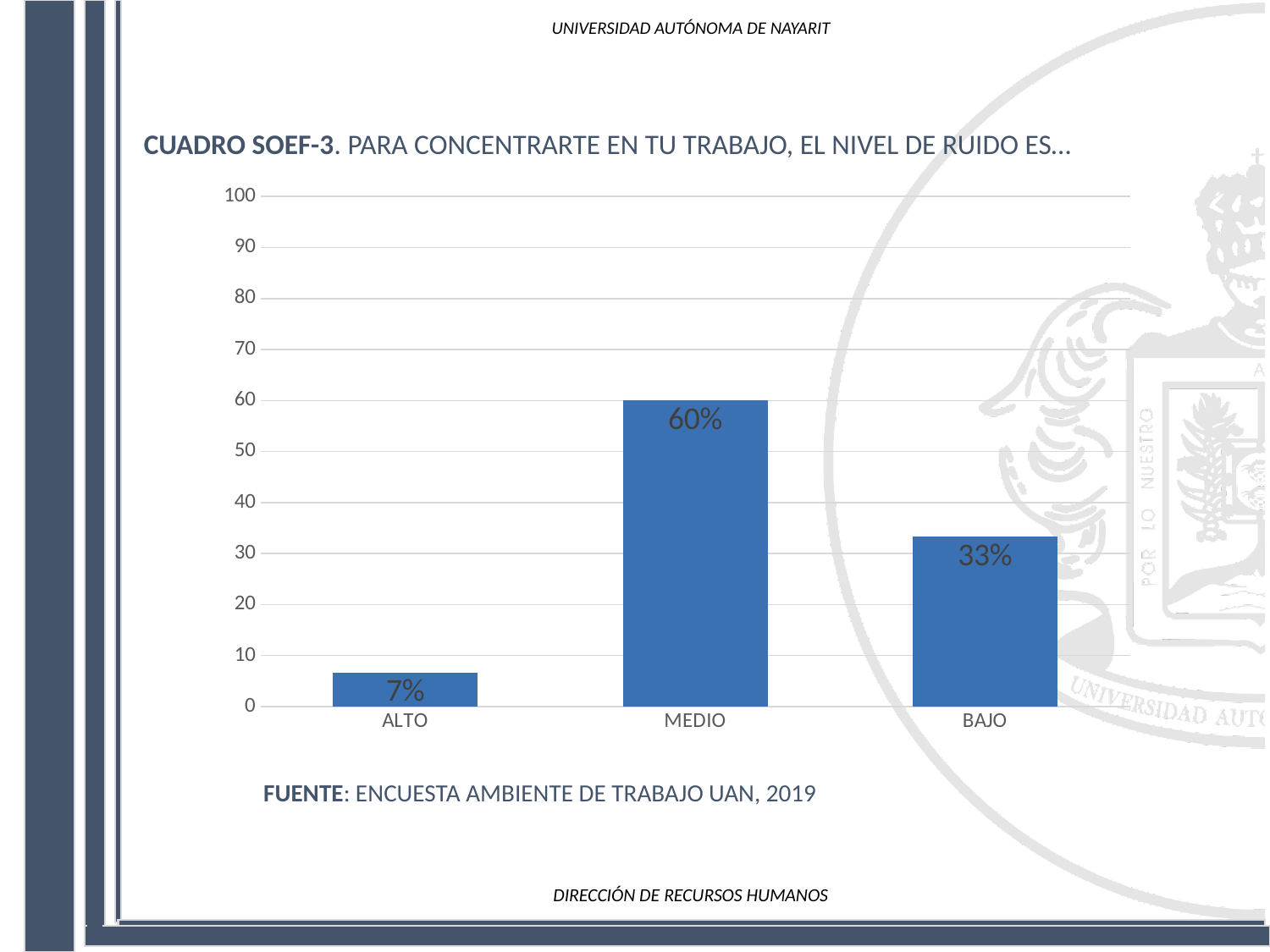
How many categories are shown on the x axis? 3 What kind of chart is shown on the slide? bar chart Which category has the lowest value? ALTO What is the value for BAJO? 33% What is the difference between the values for BAJO and ALTO? 26% What is the difference between the values for MEDIO and BAJO? 27% Which is larger, the value for BAJO or the value for ALTO? BAJO Is the value for MEDIO greater or less than 50? greater What source is cited below the chart? ENCUESTA AMBIENTE DE TRABAJO UAN, 2019 Which category has the highest value? MEDIO What is the value for ALTO? 7% What is the value for MEDIO? 60%